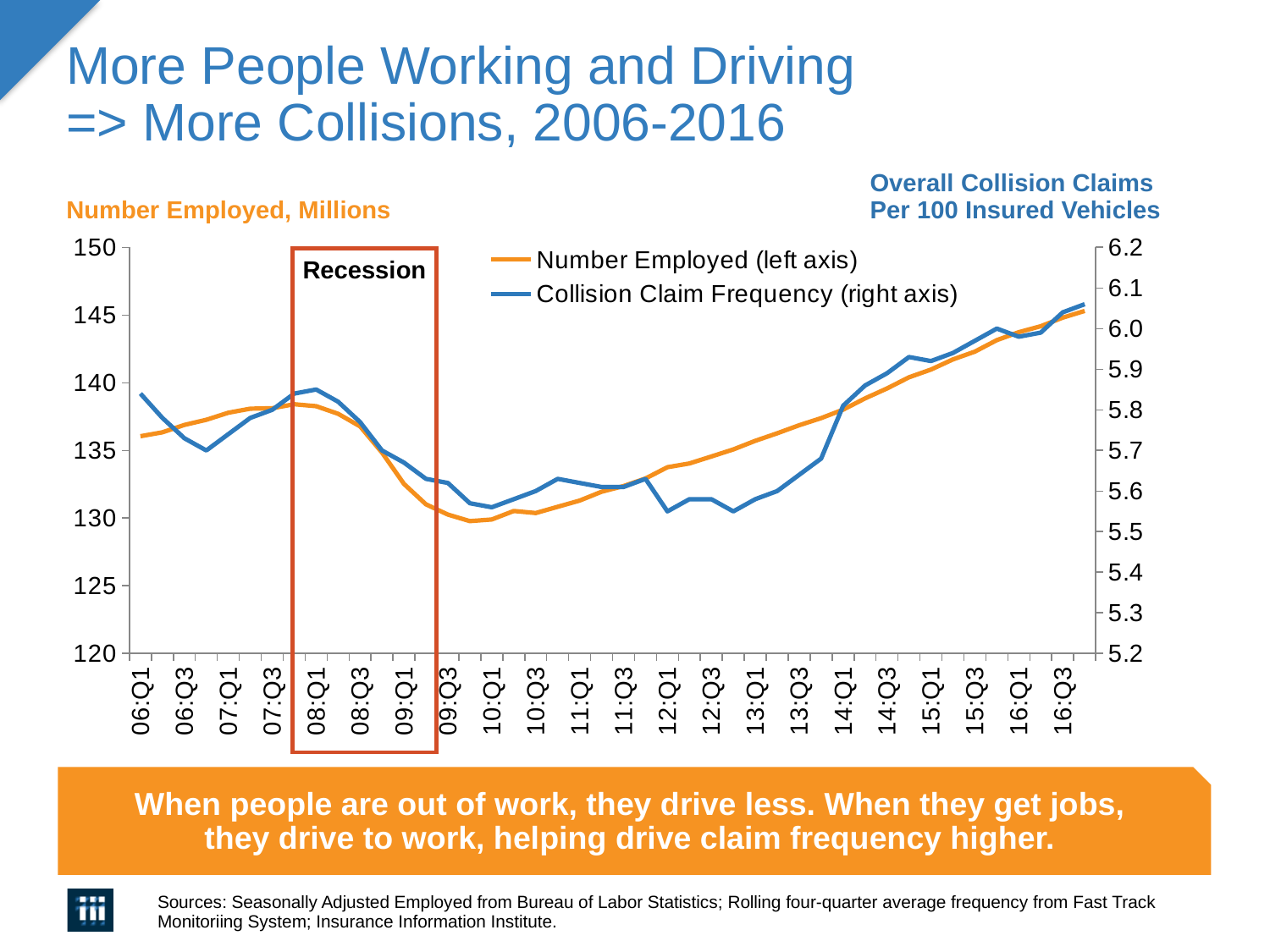
Is the value for Number Employed at 16:Q3 greater or less than 140? greater How many series does the legend list? 2 Is the value for Collision Claim Frequency at 12:Q1 greater or less than 5.7? less Is the value for Collision Claim Frequency at 06:Q1 greater or less than 5.6? greater Does the Number Employed series rise or fall from 10:Q1 to 16:Q3? rise Which is larger for Collision Claim Frequency: the value at 08:Q1 or the value at 10:Q1? 08:Q1 What is the label of the right-hand axis? Overall Collision Claims Per 100 Insured Vehicles What kind of chart is shown on the slide? line chart